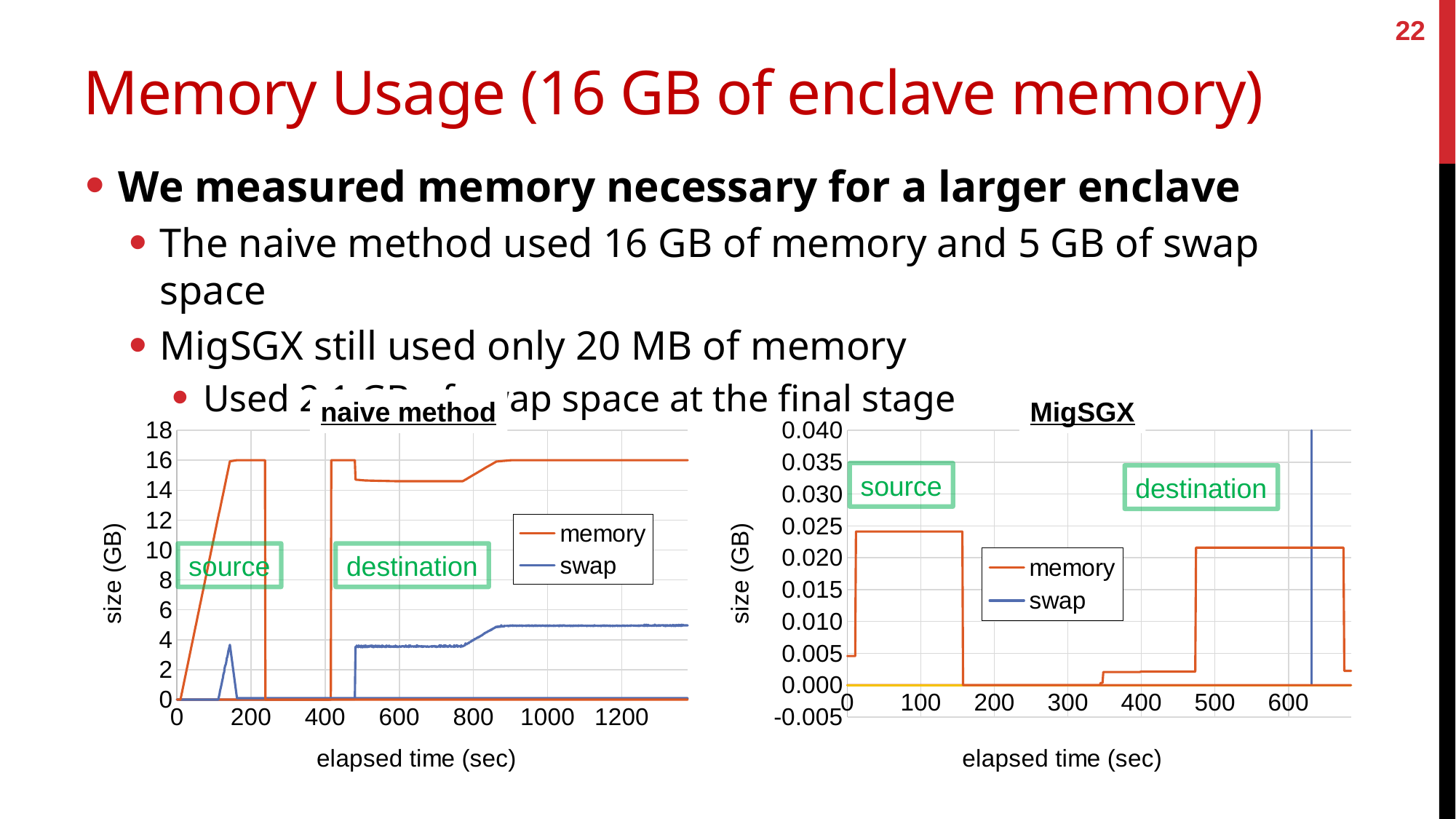
What is the x-axis label of the "MigSGX" chart? elapsed time (sec) How many series does the legend of the "MigSGX" chart list? 2 In the "MigSGX" chart, is the memory value during the source phase greater or less than 0.020? greater In the "naive method" chart, what is the peak value of the memory series during the source phase? 16 What kind of chart is the "naive method" chart? line chart In the "naive method" chart, is the swap value at the end of the destination phase greater or less than 4? greater In the "MigSGX" chart, which series is higher during the source phase, memory or swap? memory In the "naive method" chart, is the swap value at the end of the destination phase greater or less than 6? less What are the two series named in the legend of the "naive method" chart? memory and swap In the "naive method" chart, does the swap series rise or fall between 800 and 900 seconds? rise